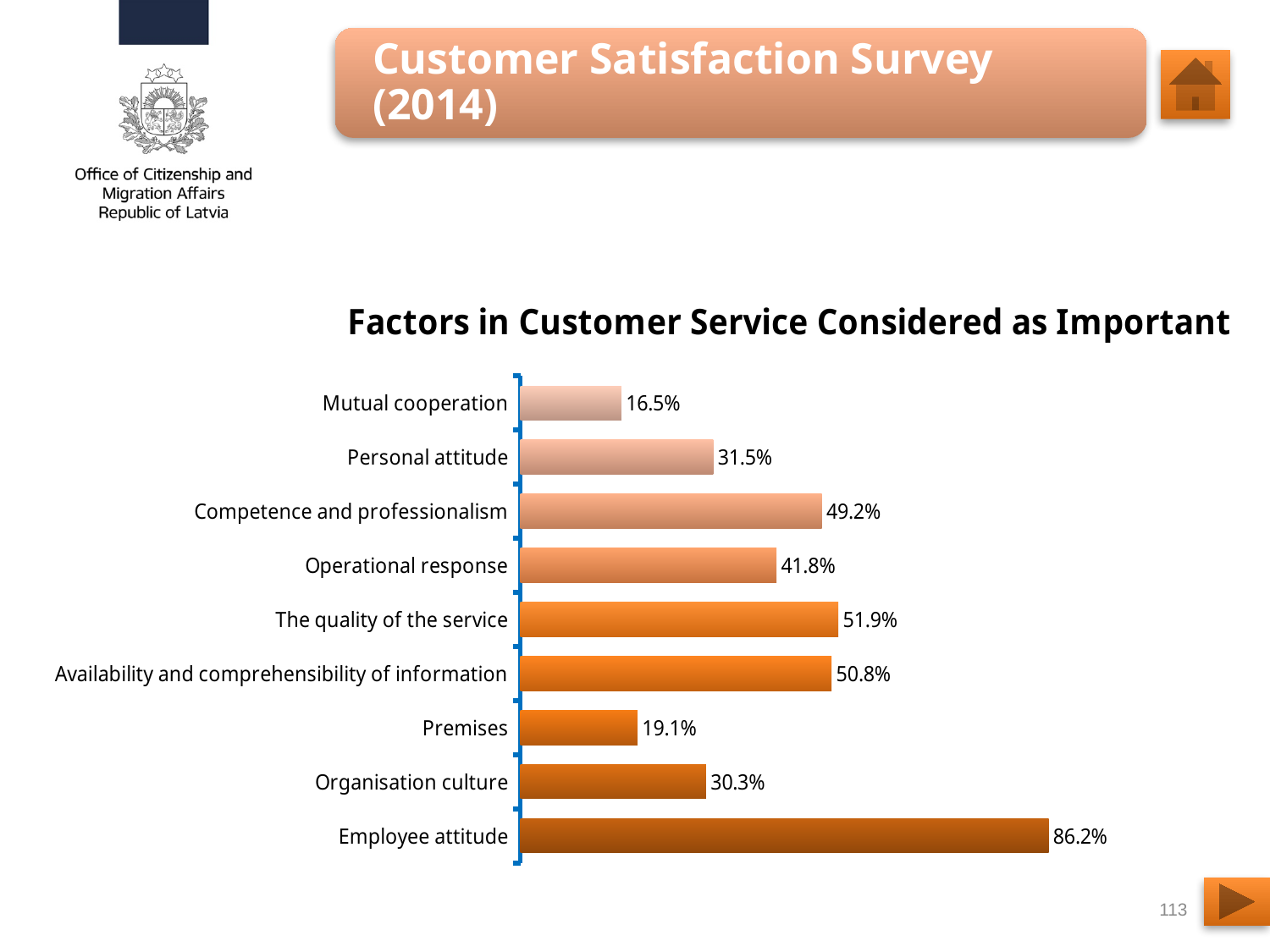
What is the value for Premises? 19.1% Which is larger, the value for Personal attitude or the value for Organisation culture? Personal attitude Which factor has the highest value? Employee attitude What is the value for Employee attitude? 86.2% What is the difference between the values for Competence and professionalism and Operational response? 7.4% What is the value for Competence and professionalism? 49.2% What is the title of the chart? Factors in Customer Service Considered as Important What is the value for Availability and comprehensibility of information? 50.8% What kind of chart is shown on the slide? Bar chart Which factor has the lowest value? Mutual cooperation How many factors are shown in the chart? 9 What is the difference between the values for Employee attitude and Mutual cooperation? 69.7%